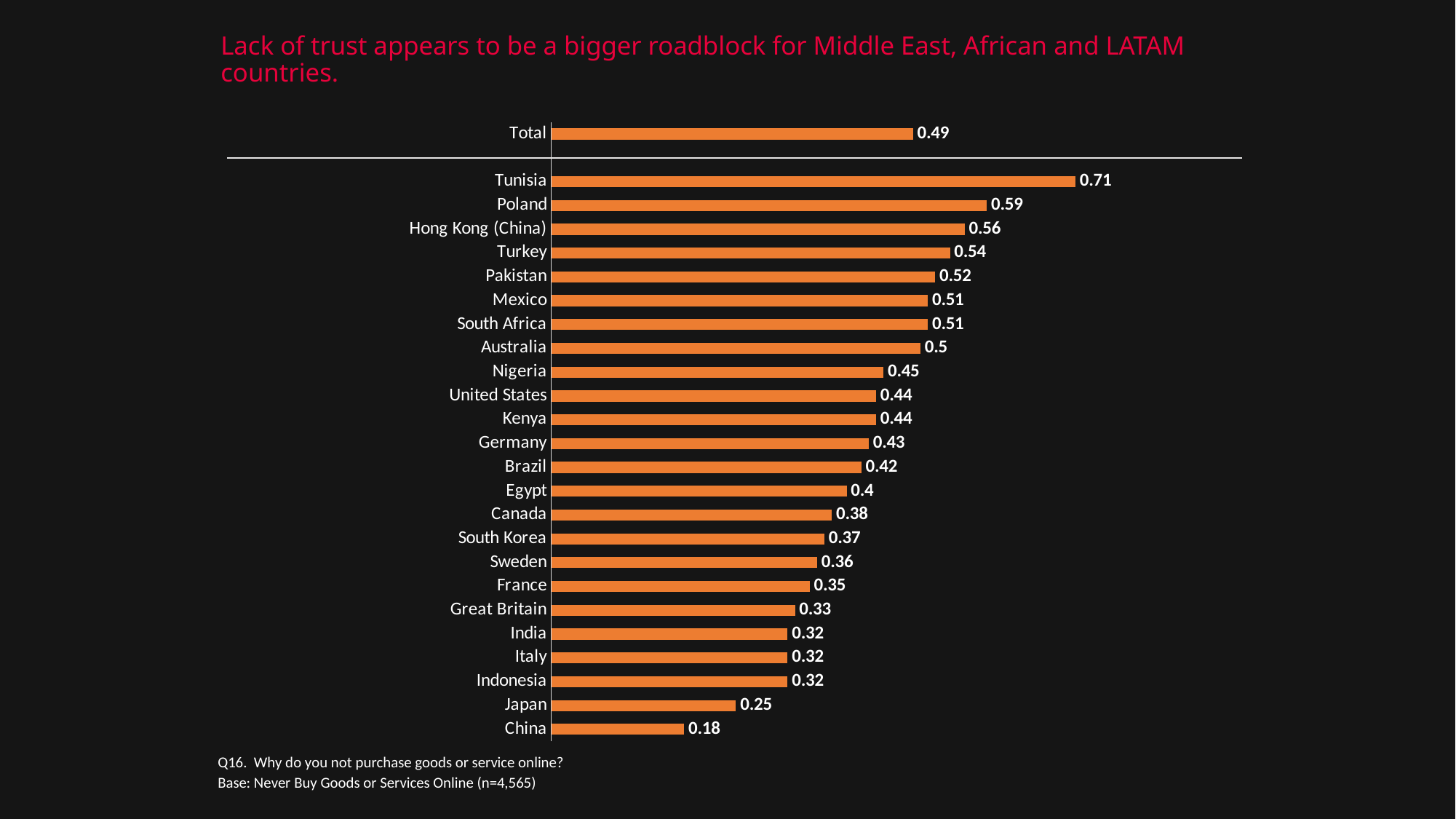
What is the difference between the values for Poland and Germany? 0.16 What colour are the bars in the chart? Orange Which country has the highest value? Tunisia What is the value for Hong Kong (China)? 0.56 What is the value for Japan? 0.25 What is the difference between the values for Tunisia and China? 0.53 What is the value for Total? 0.49 Which is larger, the value for Mexico or the value for Canada? Mexico Which country has the lowest value? China What kind of chart is shown on the slide? Bar chart What is the value for Tunisia? 0.71 How many country bars are shown below the Total bar? 24